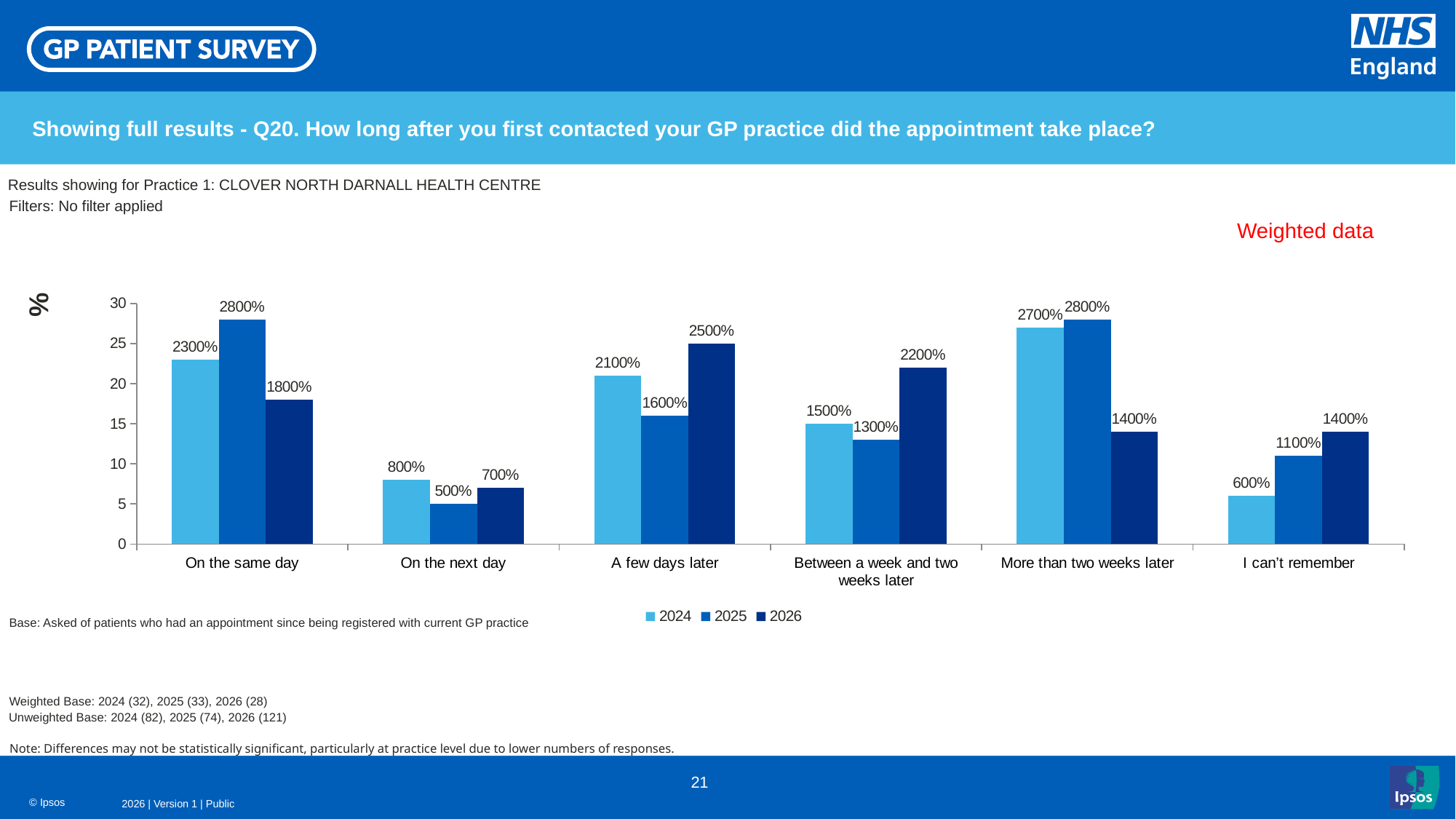
What kind of chart is shown on the slide? Bar chart What is the data label for 2026 in the 'Between a week and two weeks later' category? 2200% What is the data label for 2025 in the 'On the next day' category? 500% What is the data label for 2026 in the 'A few days later' category? 2500% In the 'More than two weeks later' category, which is larger: the 2024 value or the 2026 value? 2024 How many categories are shown on the x axis? 6 How many series does the legend list? 3 What is the data label for 2024 in the 'On the same day' category? 2300% Which category has the highest 2026 value? A few days later What is the difference between the 2025 and 2026 data labels for 'On the same day'? 1000% Which category has the lowest 2024 value? I can't remember Which series is shown in the darkest blue in the legend? 2026